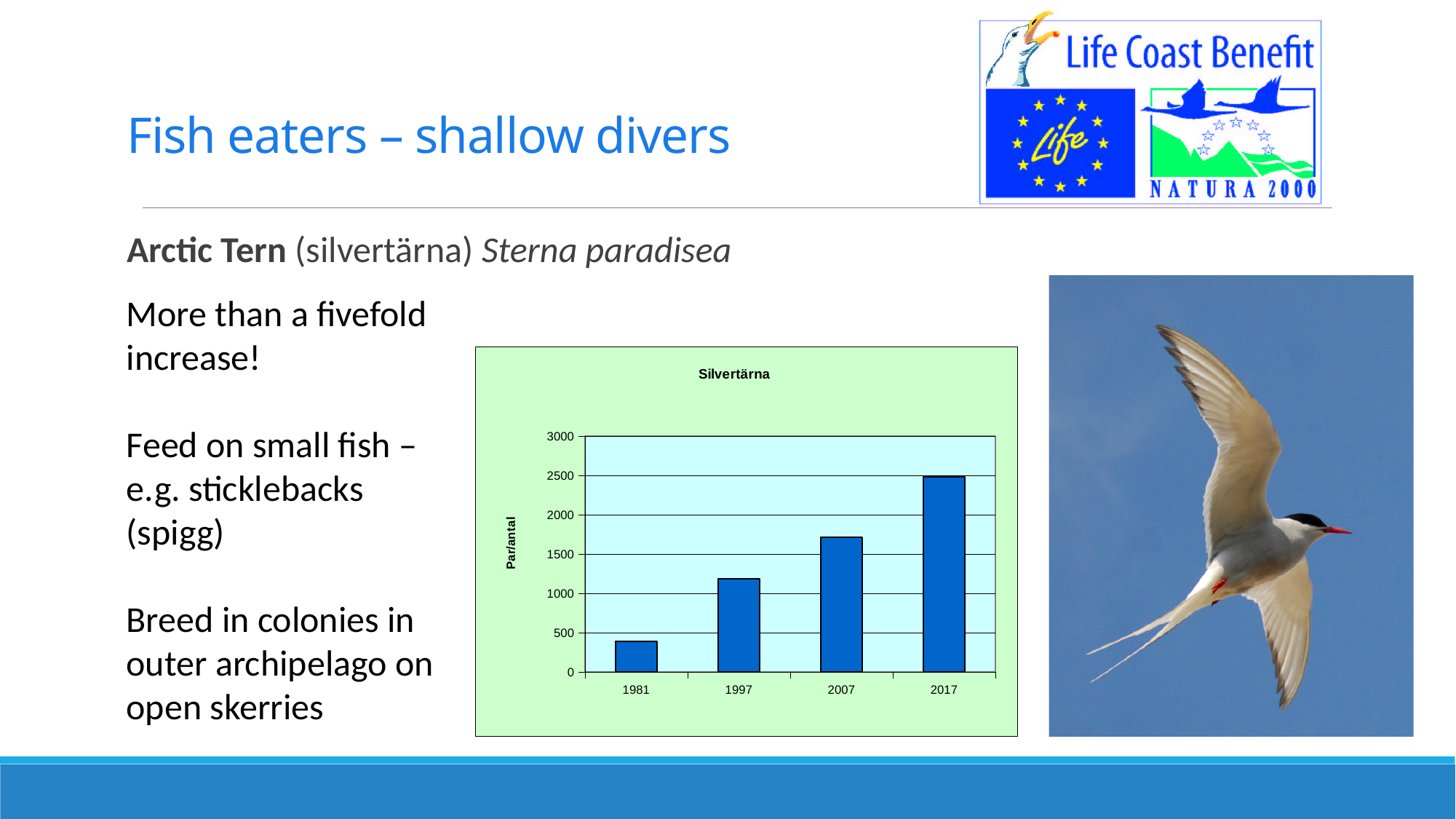
Is the value for 2017 greater or less than 2000? greater Which year has the lowest value in the chart? 1981 Is the value for 2007 greater or less than 1500? greater How many years are shown on the x axis of the chart? 4 Do the values rise or fall from 1981 to 2017? rise Is the value for 1997 greater or less than 1000? greater What kind of chart is shown on the slide? bar chart Which is larger, the value for 1997 or the value for 2007? 2007 What is the title of the chart? Silvertärna Which year has the highest value in the chart? 2017 What is the label on the vertical axis of the chart? Par/antal